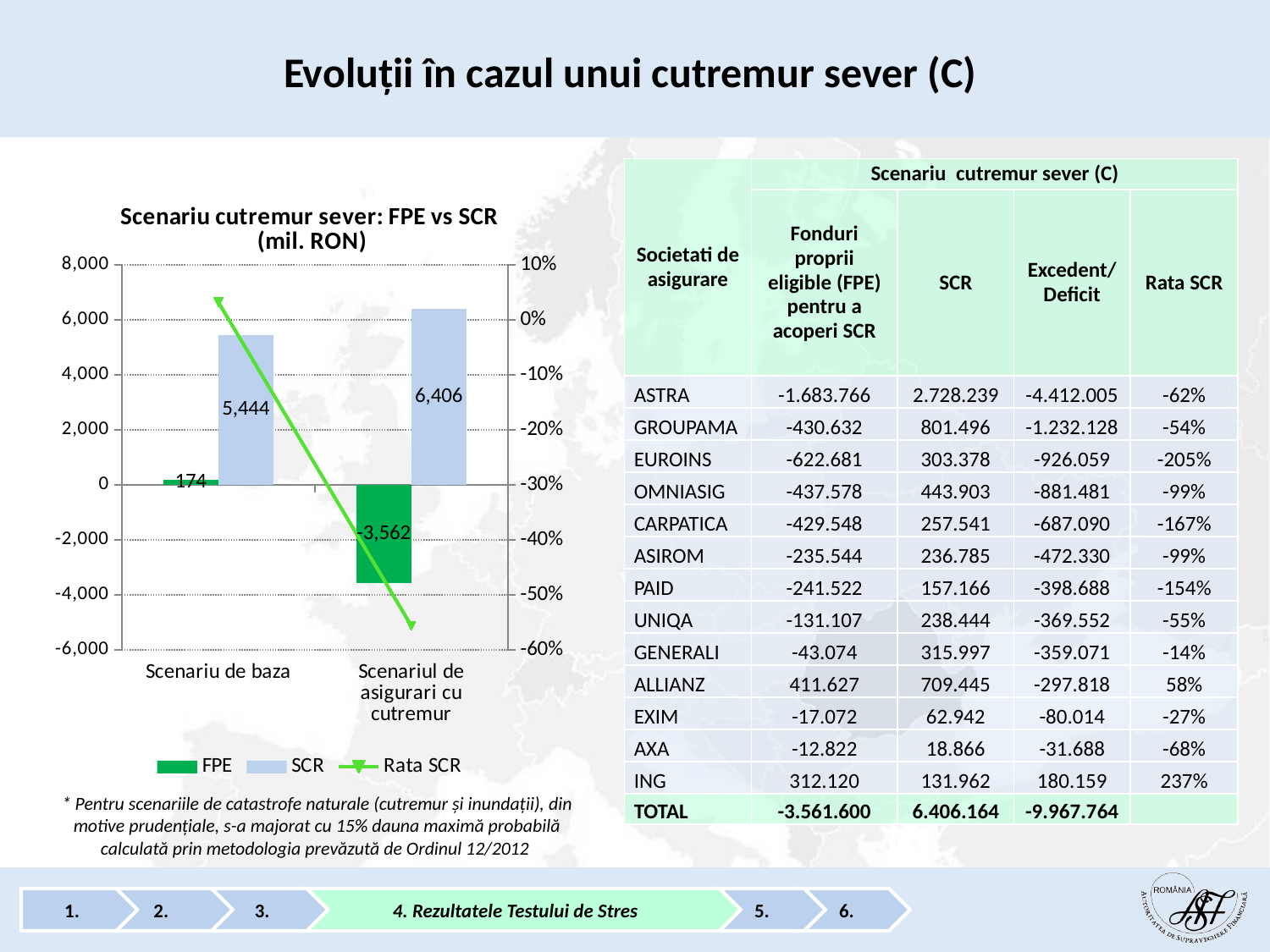
How many series does the chart legend list? 3 Which category has the higher SCR value? Scenariul de asigurari cu cutremur What is the FPE value for Scenariul de asigurari cu cutremur? -3,562 What is the SCR value for Scenariu de baza? 5,444 Is the Rata SCR value for Scenariul de asigurari cu cutremur greater or less than -50%? less What is the difference between the SCR values for Scenariul de asigurari cu cutremur and Scenariu de baza? 962 What is the title of the chart on the slide? Scenariu cutremur sever: FPE vs SCR (mil. RON) Which series in the chart is drawn as a line rather than bars? Rata SCR How many categories are shown on the x axis of the chart? 2 What is the SCR value for Scenariul de asigurari cu cutremur? 6,406 Does the FPE value rise or fall from Scenariu de baza to Scenariul de asigurari cu cutremur? fall What is the FPE value for Scenariu de baza? 174